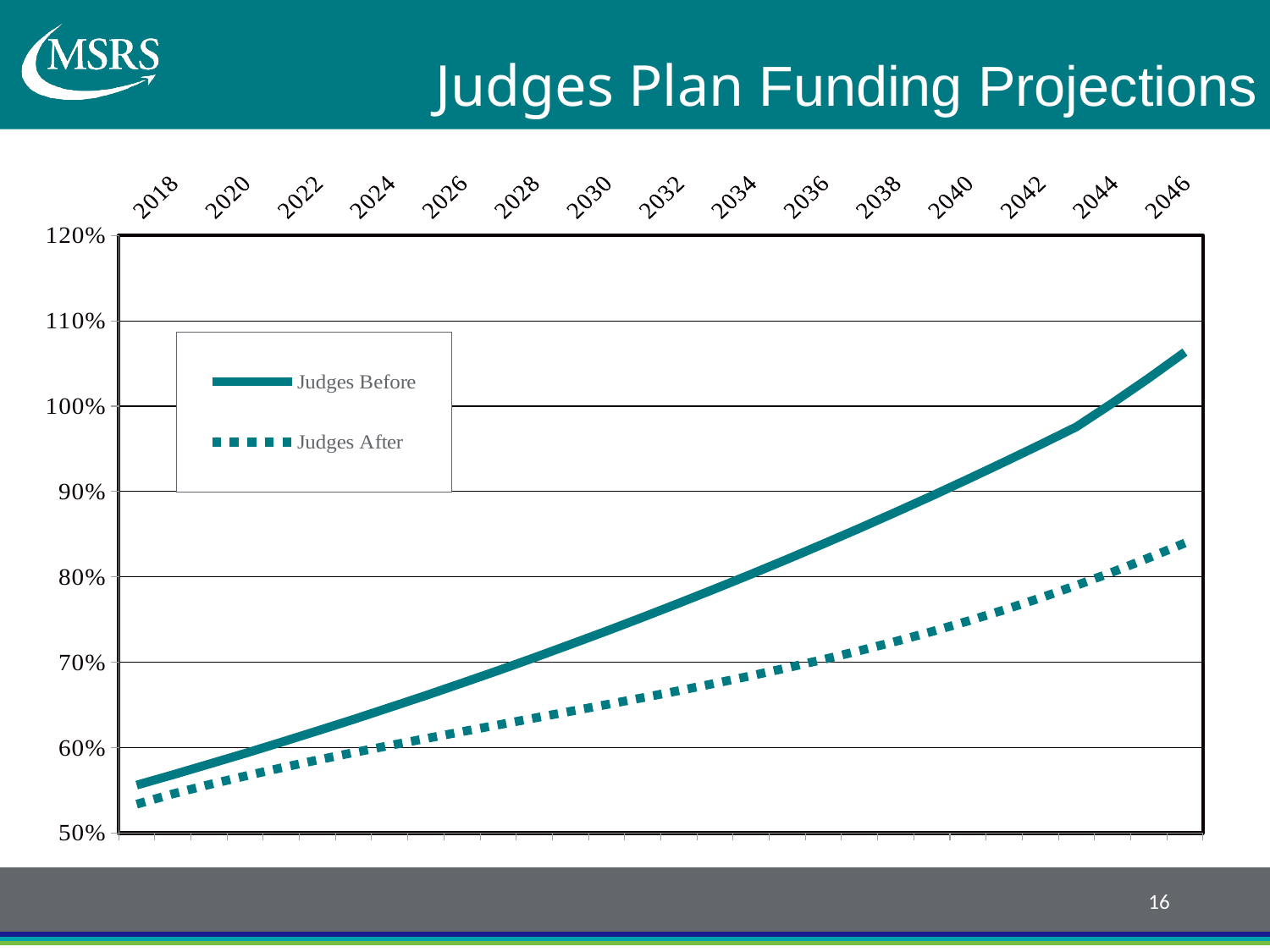
How many series does the legend list? 2 Is the value for Judges Before in 2038 greater or less than 80%? greater How many year labels are shown along the x axis? 15 Is the value for Judges Before in 2046 greater or less than 100%? greater Is the value for Judges After in 2030 greater or less than 70%? less Does the Judges Before line rise or fall from 2018 to 2046? rise What kind of chart is shown on the slide? line chart In 2046, which series has the higher value, Judges Before or Judges After? Judges Before Does the Judges After line rise or fall from 2018 to 2046? rise Which series is drawn with a dashed line? Judges After